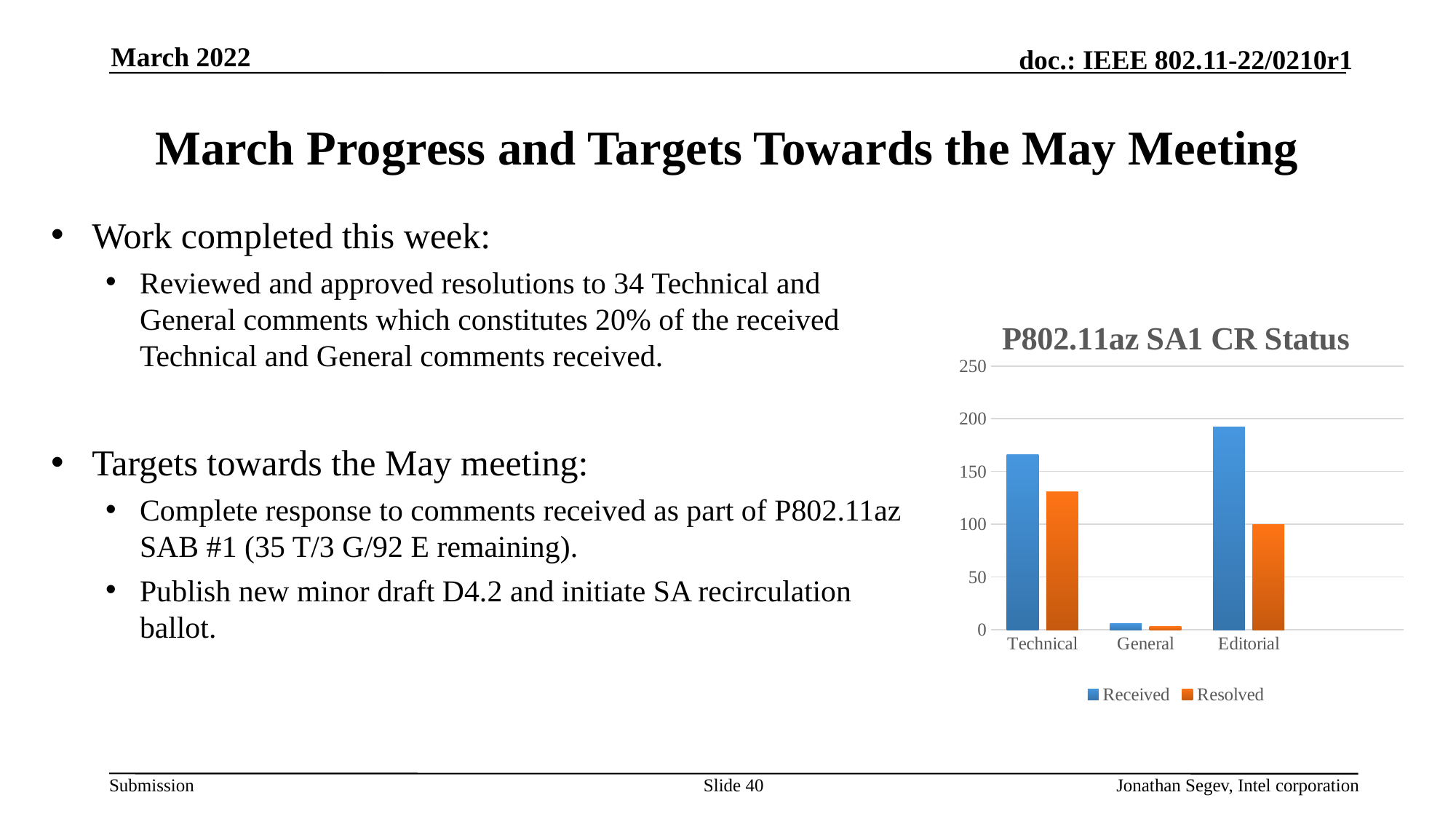
What are the two series named in the chart legend? Received and Resolved How many series does the chart legend list? 2 What kind of chart is shown on the slide? bar chart Is the Resolved value for General greater or less than 50? less Which category has the lowest Received value? General Which category has the highest Resolved value? Technical Which is larger, the Resolved value for Technical or the Resolved value for Editorial? Technical How many categories are shown on the x axis of the chart? 3 Is the Received value for Editorial greater or less than 200? less What is the title of the chart on the slide? P802.11az SA1 CR Status Which category has the highest Received value? Editorial Is the Received value for Technical greater or less than 150? greater